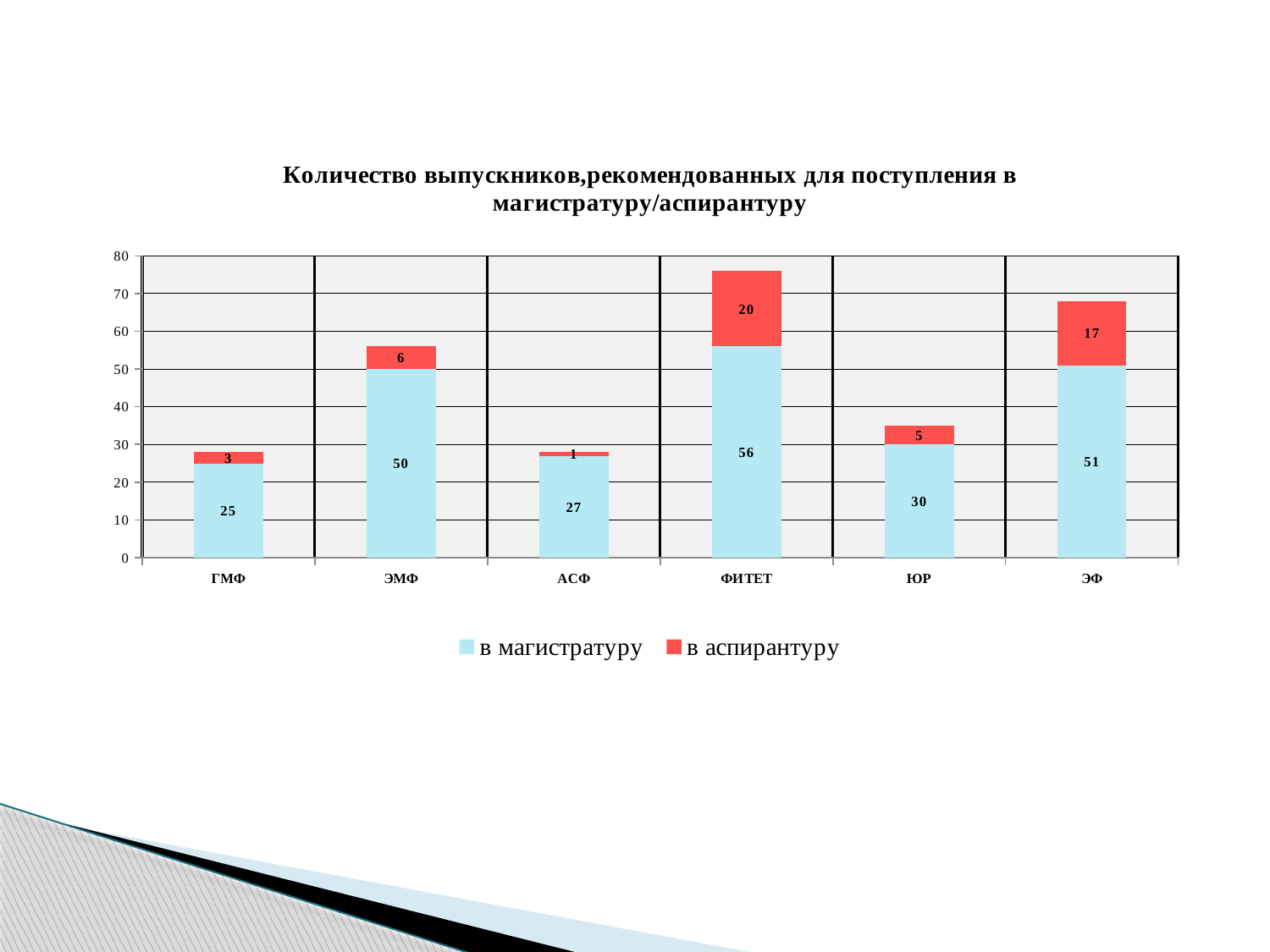
What is the value for ЭФ in the 'в аспирантуру' series? 17 Which category has the lowest value in the 'в магистратуру' series? ГМФ What is the total of the stacked bar for ФИТЕТ? 76 What is the value for ЮР in the 'в магистратуру' series? 30 Which is larger: the 'в аспирантуру' value for ЭМФ or for ЮР? ЭМФ How many categories are shown on the x axis? 6 How many series does the legend list? 2 What is the total of the stacked bar for АСФ? 28 What kind of chart is shown on the slide? Stacked bar chart What is the difference between the 'в магистратуру' values for ЭМФ and ГМФ? 25 Which category has the highest value in the 'в аспирантуру' series? ФИТЕТ What is the value for ФИТЕТ in the 'в магистратуру' series? 56